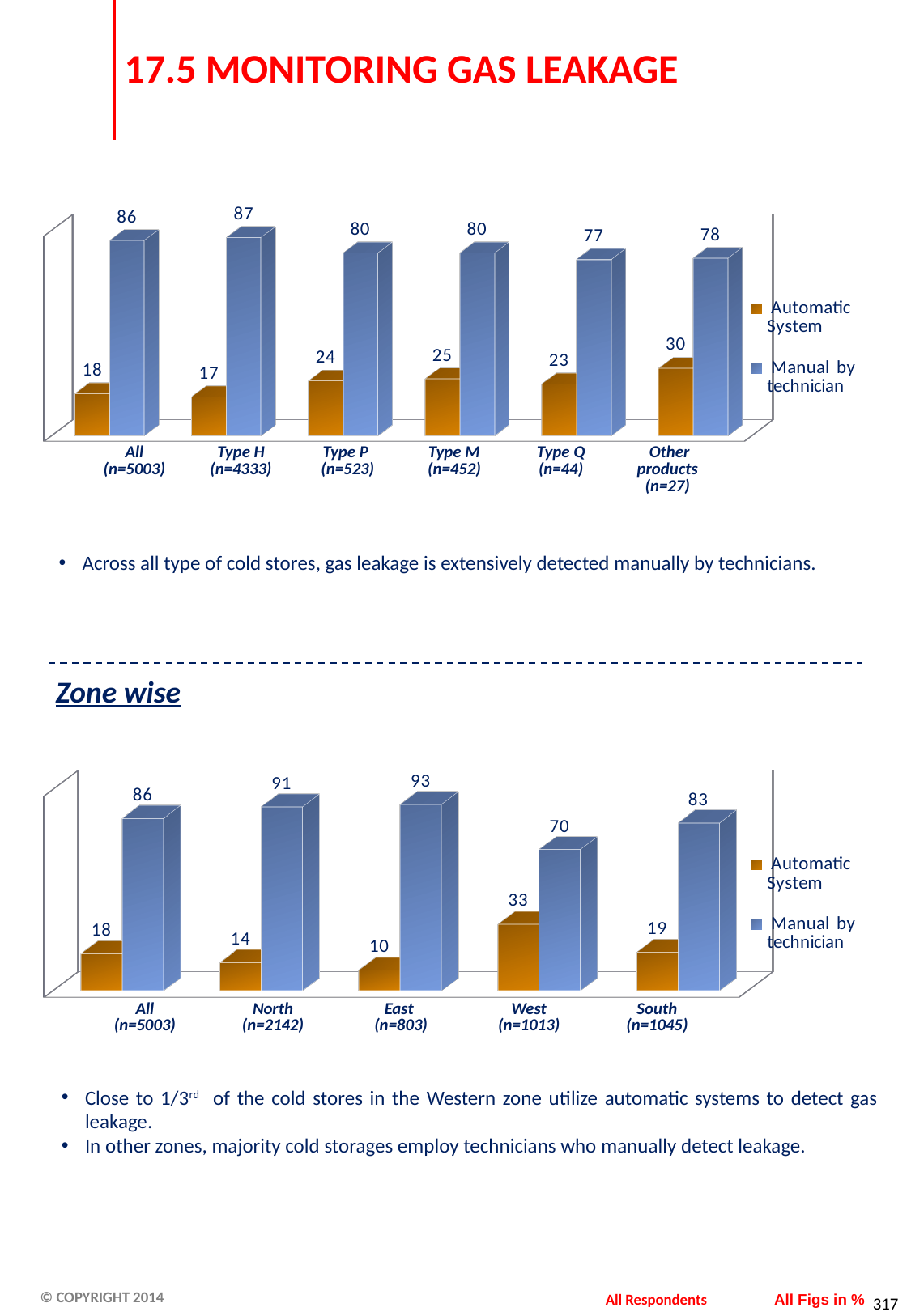
In the Zone wise chart, which zone has the highest Manual by technician value? East (n=803) In the top chart, what is the value for Automatic System for Other products (n=27)? 30 In the top chart, which category has the lowest Automatic System value? Type H (n=4333) In the top chart, how many categories are shown on the x axis? 6 In the Zone wise chart, is the Manual by technician value larger for North (n=2142) or South (n=1045)? North (n=2142) In the top chart, what is the value for Manual by technician for Type H (n=4333)? 87 In the Zone wise chart, what is the difference between the Manual by technician values for East (n=803) and West (n=1013)? 23 In the Zone wise chart, which zone has the lowest Automatic System value? East (n=803) In the top chart, how many series does the legend list? 2 What kind of chart is the Zone wise chart? Bar chart In the top chart, what is the difference between Manual by technician and Automatic System for All (n=5003)? 68 In the Zone wise chart, what is the value for Automatic System for West (n=1013)? 33